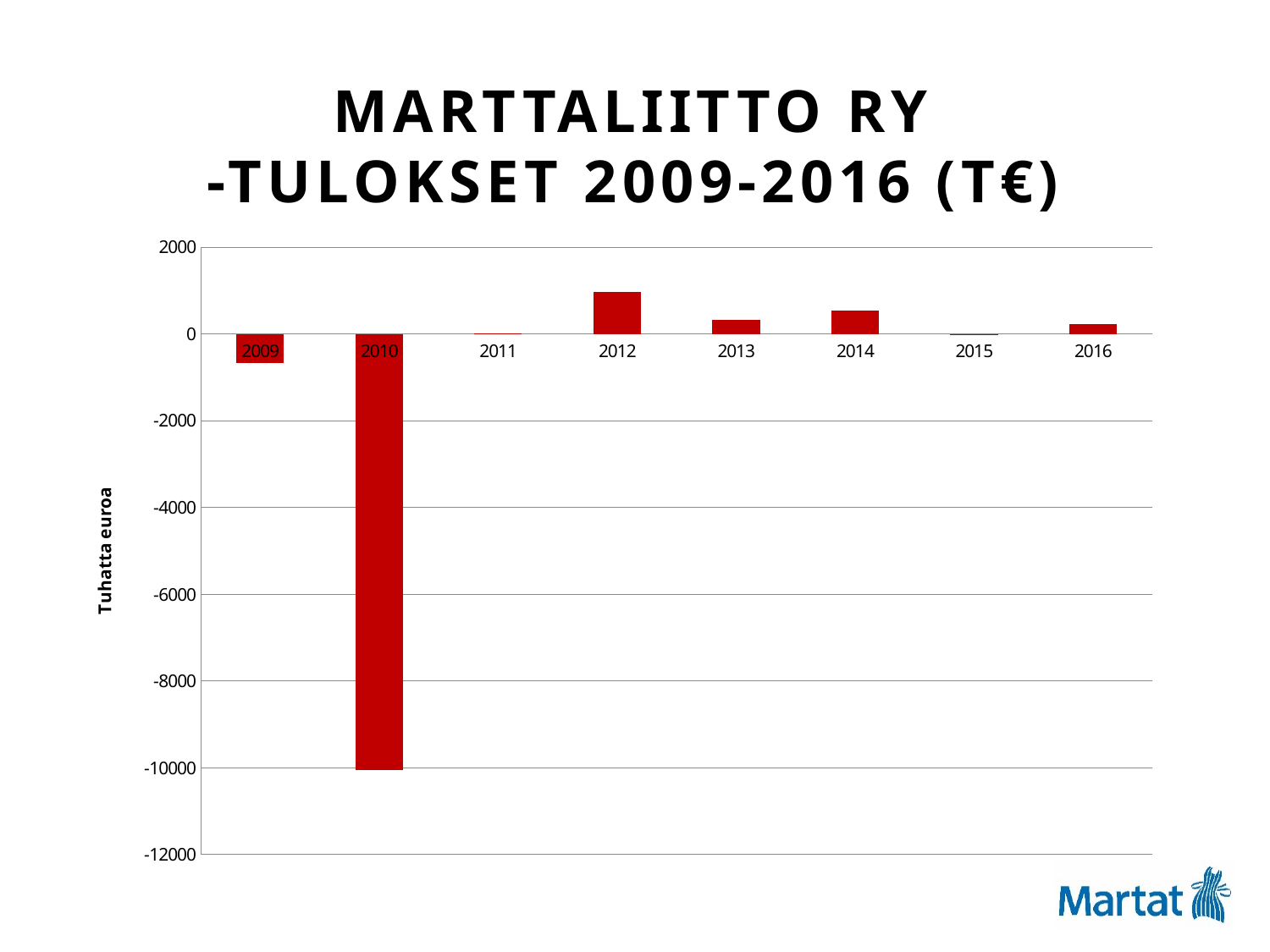
What kind of chart is shown on the slide? bar chart Which year has the lowest value in the chart? 2010 Is the value for 2014 greater or less than 0? greater Which year has the highest value in the chart? 2012 Which year has the larger value, 2012 or 2013? 2012 What is the title of the slide containing the chart? MARTTALIITTO RY -TULOKSET 2009-2016 (T€) Is the value for 2012 greater or less than 2000? less What is the label on the vertical axis of the chart? Tuhatta euroa Is the value for 2009 greater or less than -2000? greater Which year has the larger value, 2014 or 2016? 2014 How many years are plotted on the x axis of the chart? 8